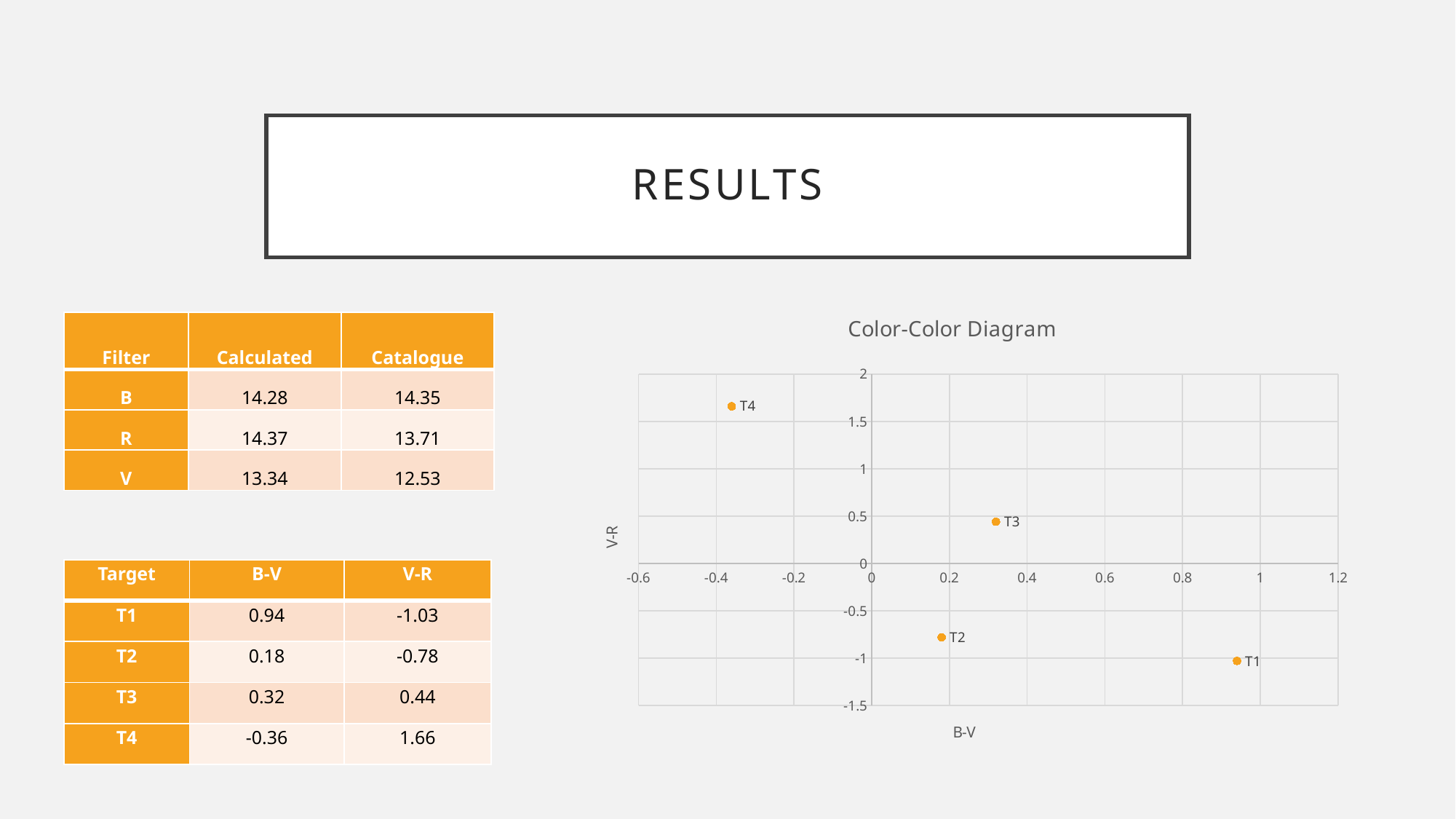
In the Color-Color Diagram, which target has the lowest V-R value? T1 In the Color-Color Diagram, is the B-V value for T1 greater or less than 0.8? greater What is the V-R value for T3 plotted in the Color-Color Diagram? 0.44 In the Color-Color Diagram, which target has the lowest B-V value? T4 In the Color-Color Diagram, which target has the highest B-V value? T1 In the Color-Color Diagram, which has a larger V-R value, T3 or T2? T3 How many data points are plotted in the Color-Color Diagram? 4 In the Color-Color Diagram, which target has the highest V-R value? T4 What kind of chart is the Color-Color Diagram? scatter chart In the Color-Color Diagram, is the V-R value for T4 greater or less than 1.5? greater What is the label of the horizontal axis of the Color-Color Diagram? B-V What is the title of the chart on the slide? Color-Color Diagram